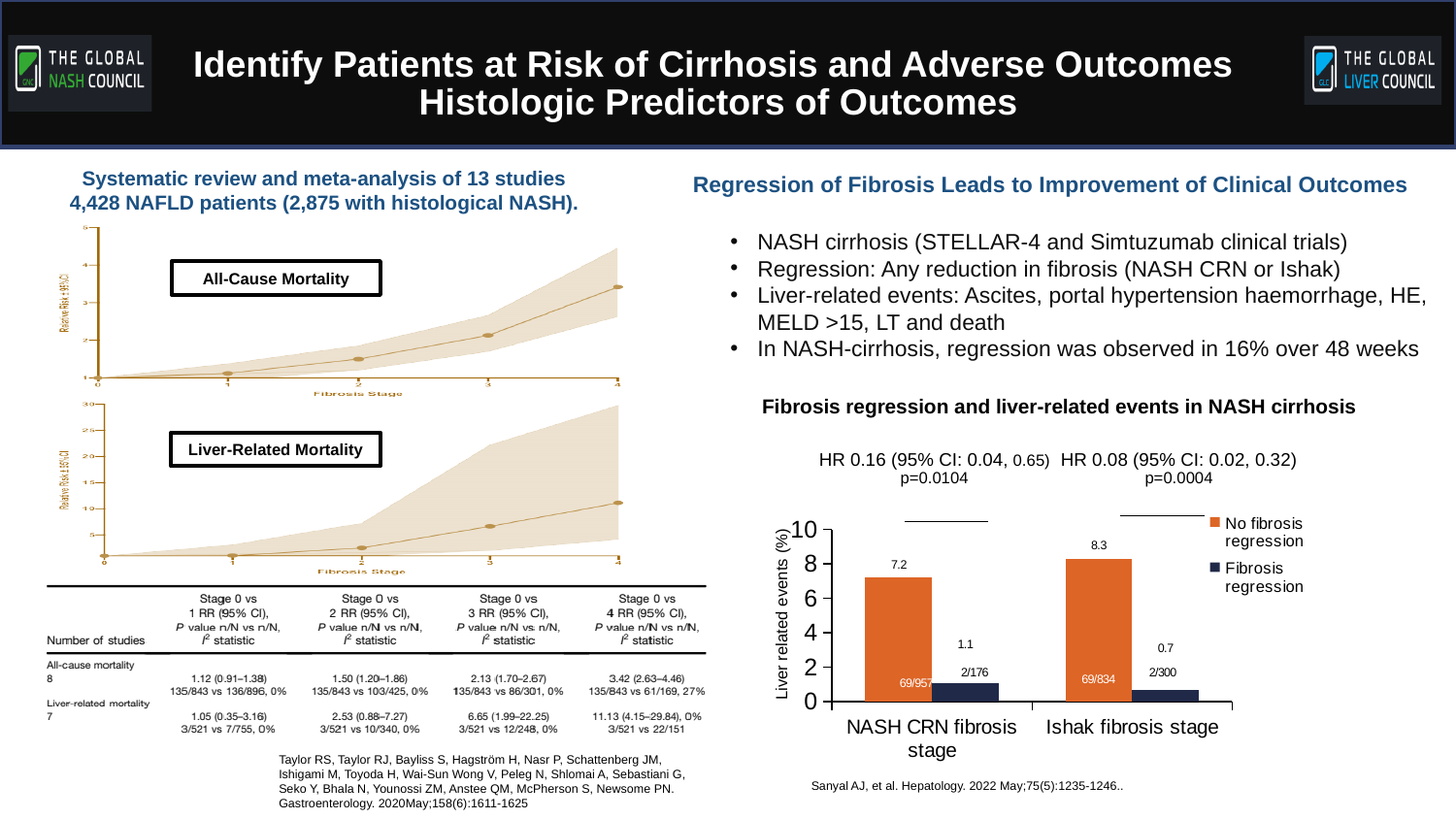
In the bar chart titled 'Fibrosis regression and liver-related events in NASH cirrhosis', which is larger: the 'No fibrosis regression' value for NASH CRN fibrosis stage or for Ishak fibrosis stage? Ishak fibrosis stage In the bar chart titled 'Fibrosis regression and liver-related events in NASH cirrhosis', how many series does the legend list? 2 In the bar chart titled 'Fibrosis regression and liver-related events in NASH cirrhosis', what is the value for 'Fibrosis regression' in the NASH CRN fibrosis stage category? 1.1 In the bar chart titled 'Fibrosis regression and liver-related events in NASH cirrhosis', which bar has the highest value? No fibrosis regression, Ishak fibrosis stage (8.3) In the 'Liver-Related Mortality' line chart on the left, do the relative risk values rise or fall as fibrosis stage increases from 0 to 4? rise What kind of chart is the 'Fibrosis regression and liver-related events in NASH cirrhosis' chart? Bar chart In the bar chart titled 'Fibrosis regression and liver-related events in NASH cirrhosis', which bar has the lowest value? Fibrosis regression, Ishak fibrosis stage (0.7) In the bar chart titled 'Fibrosis regression and liver-related events in NASH cirrhosis', how many categories are shown on the x axis? 2 In the bar chart titled 'Fibrosis regression and liver-related events in NASH cirrhosis', what is the value for 'Fibrosis regression' in the Ishak fibrosis stage category? 0.7 In the 'All-Cause Mortality' line chart on the left, is the relative risk at fibrosis stage 4 greater or less than 3? greater In the bar chart titled 'Fibrosis regression and liver-related events in NASH cirrhosis', what is the value for 'No fibrosis regression' in the NASH CRN fibrosis stage category? 7.2 In the bar chart titled 'Fibrosis regression and liver-related events in NASH cirrhosis', what is the difference between the 'No fibrosis regression' and 'Fibrosis regression' values in the NASH CRN fibrosis stage category? 6.1